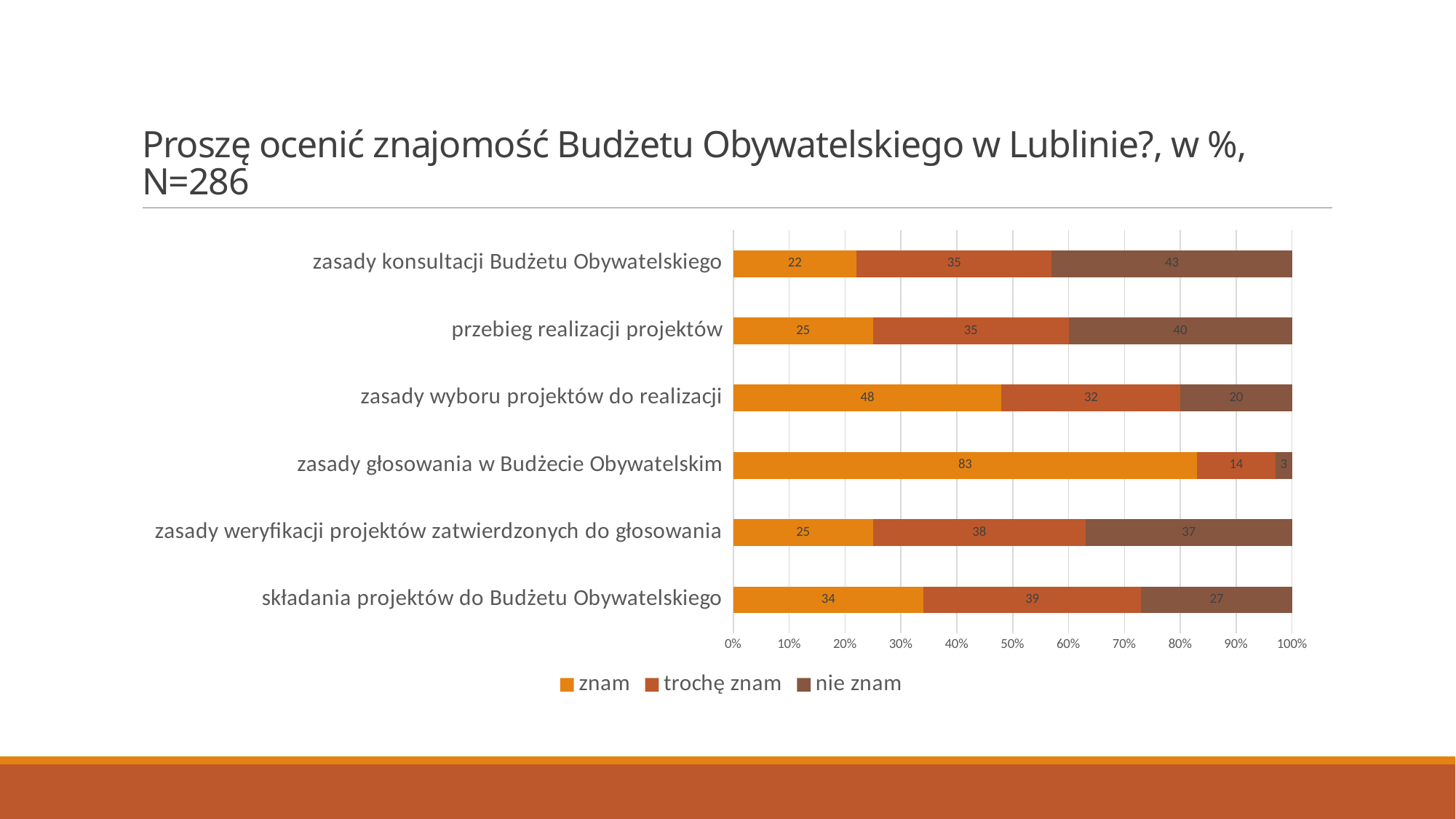
Which is larger: the "nie znam" value for "przebieg realizacji projektów" or for "zasady weryfikacji projektów zatwierdzonych do głosowania"? przebieg realizacji projektów What kind of chart is shown on the slide? stacked bar chart What is the "nie znam" value for "zasady konsultacji Budżetu Obywatelskiego"? 43 Which category has the highest "znam" value? zasady głosowania w Budżecie Obywatelskim What is the total of the stacked bar for "zasady wyboru projektów do realizacji"? 100 How many categories are shown on the chart? 6 Which category has the lowest "nie znam" value? zasady głosowania w Budżecie Obywatelskim How many series does the legend list? 3 Which legend entry is shown in the darkest brown colour? nie znam What is the "trochę znam" value for "składania projektów do Budżetu Obywatelskiego"? 39 What is the difference between the "znam" values for "zasady wyboru projektów do realizacji" and "składania projektów do Budżetu Obywatelskiego"? 14 What is the "znam" value for "zasady głosowania w Budżecie Obywatelskim"? 83